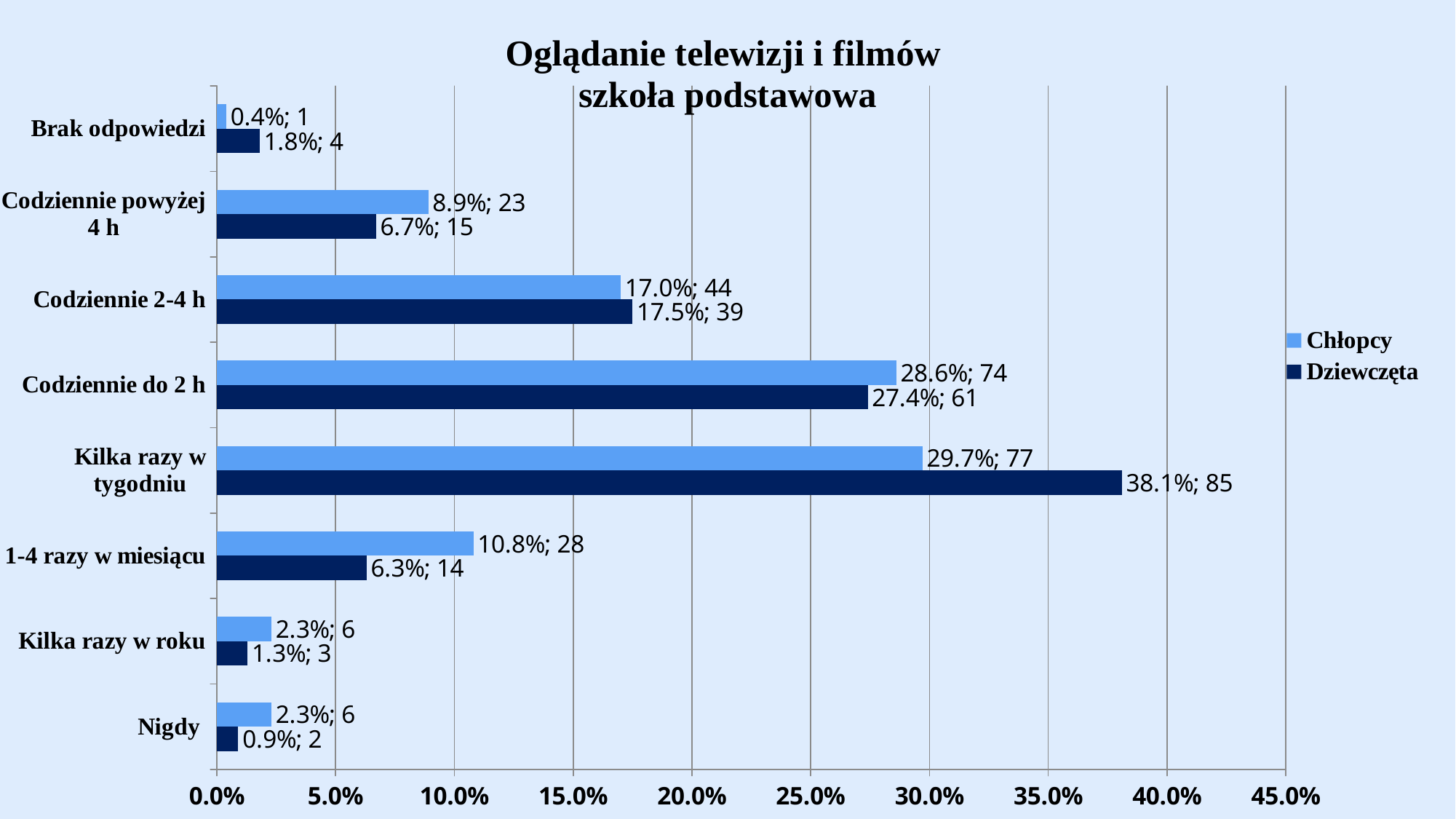
What is the difference in percentage points between Dziewczęta and Chłopcy in the category 'Kilka razy w tygodniu'? 8.4 What is the percentage for Dziewczęta in the category 'Codziennie do 2 h'? 27.4% How many series does the legend list? 2 What kind of chart is shown on the slide? bar chart Is the value for Dziewczęta in 'Kilka razy w tygodniu' greater or less than 35.0%? greater Which category has the lowest percentage for Chłopcy? Brak odpowiedzi Which category has the highest percentage for Dziewczęta? Kilka razy w tygodniu What is the title of the chart? Oglądanie telewizji i filmów szkoła podstawowa How many categories are shown on the chart? 8 In the category '1-4 razy w miesiącu', which series has the larger percentage, Chłopcy or Dziewczęta? Chłopcy How many Dziewczęta respondents are in the category 'Kilka razy w tygodniu'? 85 What is the percentage for Chłopcy in the category 'Kilka razy w tygodniu'? 29.7%